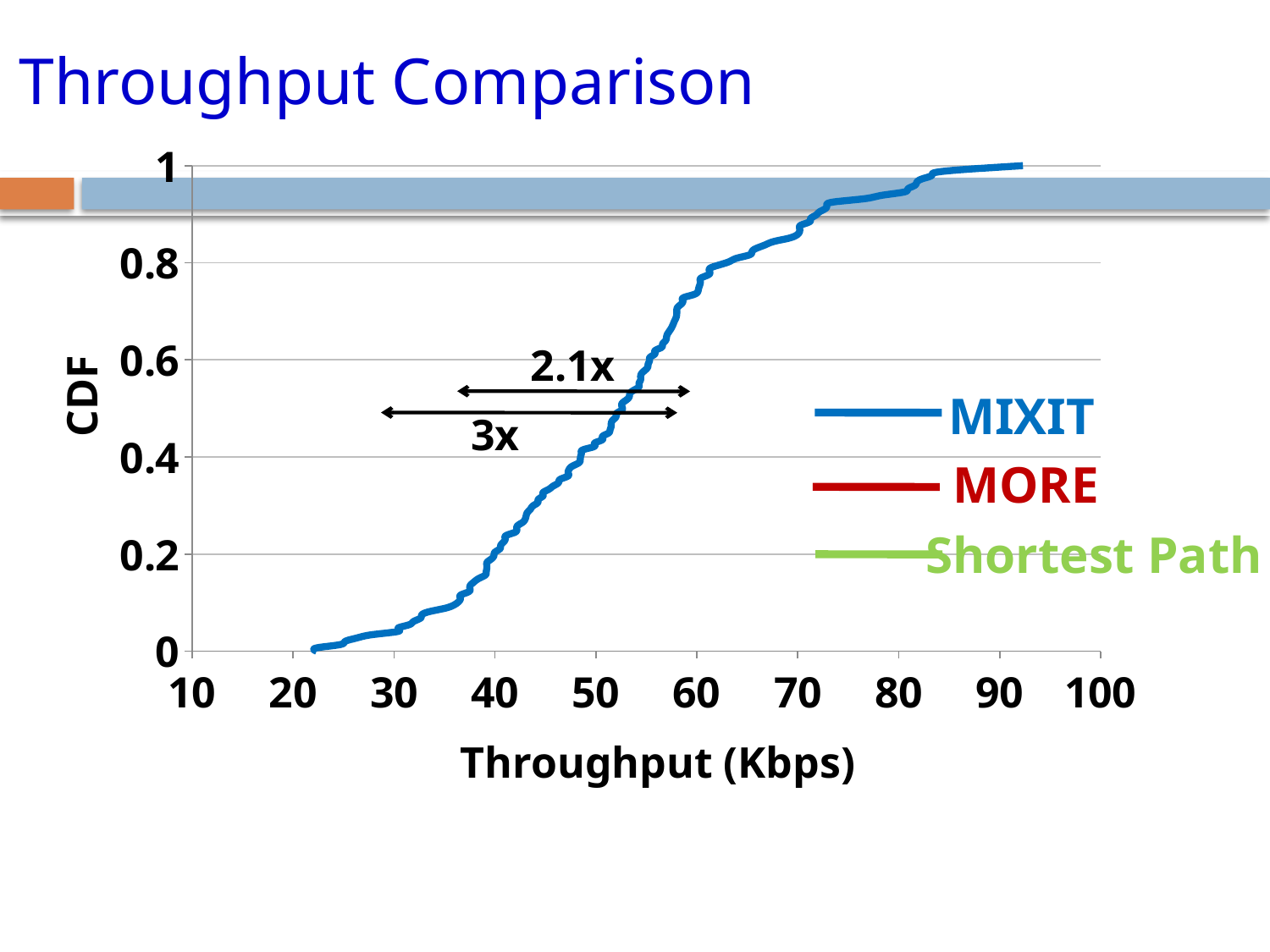
Is the CDF value of the MIXIT curve at 30 Kbps greater or less than 0.2? less What is the title of the slide's chart? Throughput Comparison Is the CDF value of the MIXIT curve at 70 Kbps greater or less than 0.8? greater What is the highest CDF value reached by the MIXIT curve? 1 Is the CDF value of the MIXIT curve at 40 Kbps greater or less than 0.4? less Does the MIXIT curve rise or fall as throughput increases along the x axis? rise What kind of chart is shown on the slide? line chart What is the label of the x axis? Throughput (Kbps) How many series does the legend list? 3 Which series in the legend is drawn in red? MORE